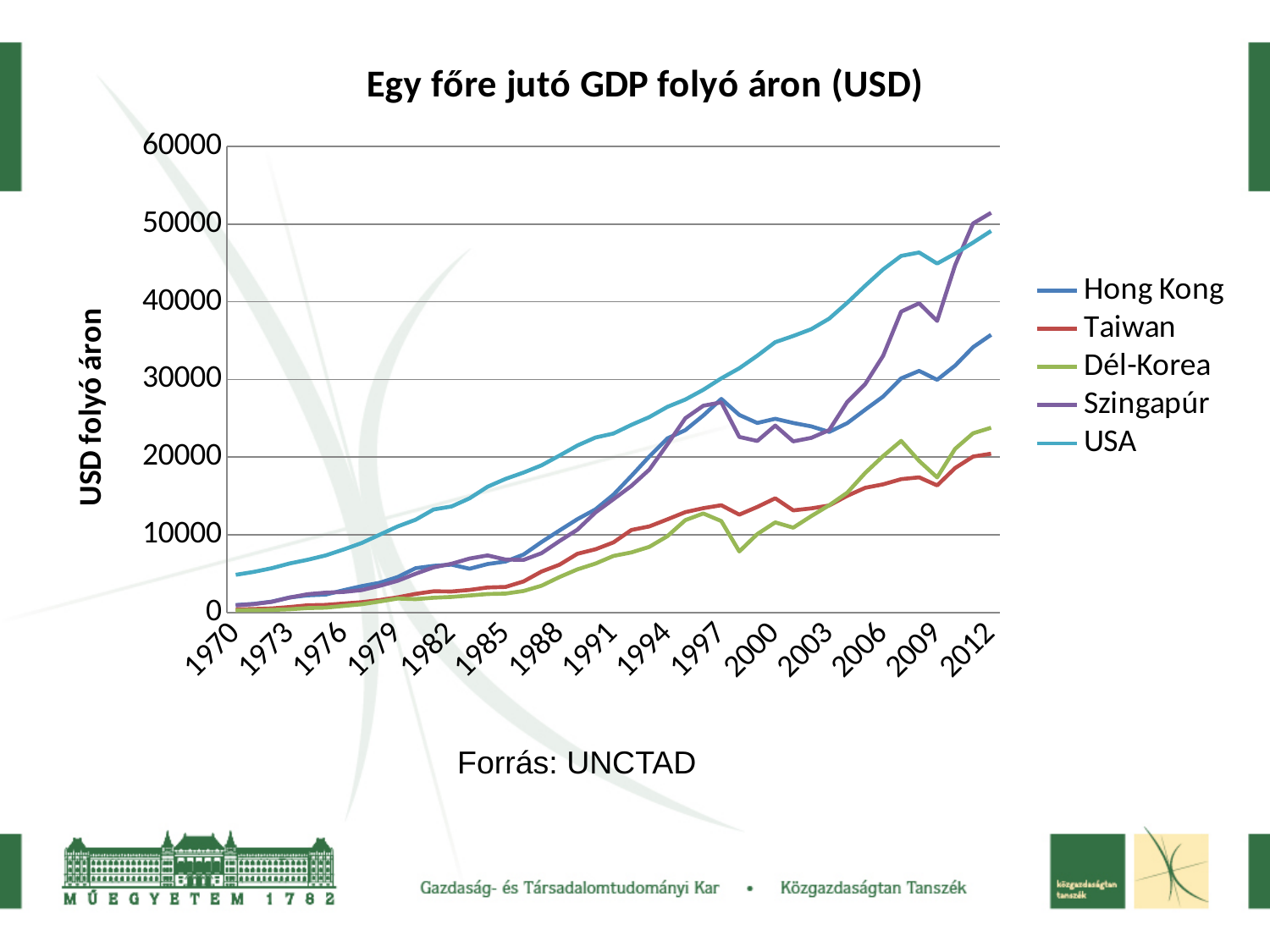
Is the value for Hong Kong in 2012 greater or less than 40000? less What is the label of the vertical axis? USD folyó áron What kind of chart is shown on the slide? line chart Does the USA line rise or fall overall from 1970 to 2012? rise Is the value for USA in 1970 greater or less than 10000? less Is the value for Taiwan in 2012 greater or less than 30000? less Which series has the highest value in 2012? Szingapúr Which series has the highest value in 1990? USA What is the title of the chart? Egy főre jutó GDP folyó áron (USD) How many series does the legend list? 5 In 2012, which is larger: the value for Hong Kong or the value for Taiwan? Hong Kong